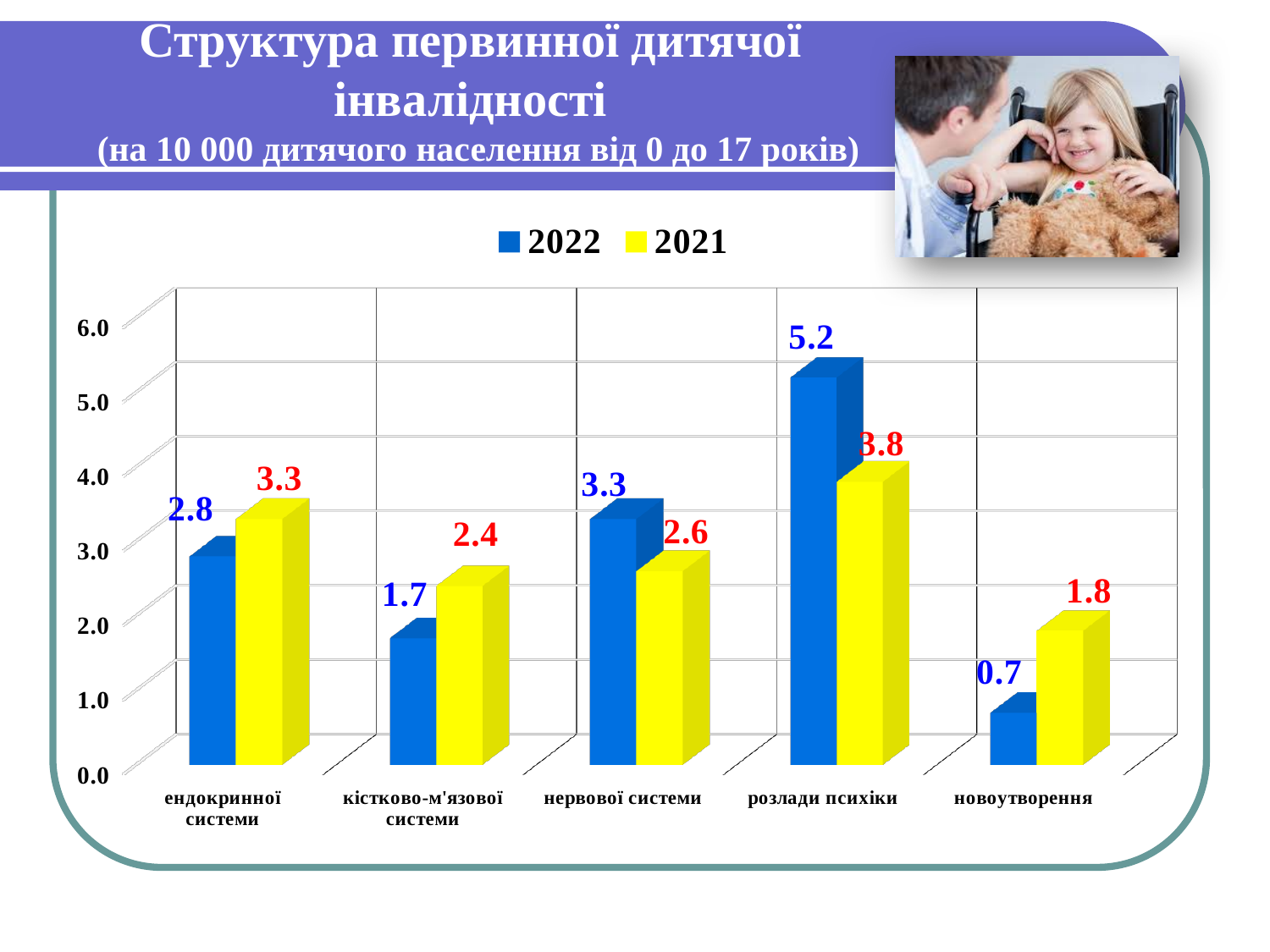
What is the 2021 value for кістково-м'язової системи? 2.4 What is the 2022 value for розлади психіки? 5.2 What is the difference between the 2022 and 2021 values for розлади психіки? 1.4 What is the 2022 value for новоутворення? 0.7 Which is larger for ендокринної системи: the 2022 value or the 2021 value? 2021 What is the difference between the 2021 and 2022 values for новоутворення? 1.1 How many series does the legend list? 2 What kind of chart is shown on the slide? bar chart Which is larger for нервової системи: the 2022 value or the 2021 value? 2022 Which category has the highest 2021 value? розлади психіки Which category has the lowest 2022 value? новоутворення How many categories are shown on the x axis? 5